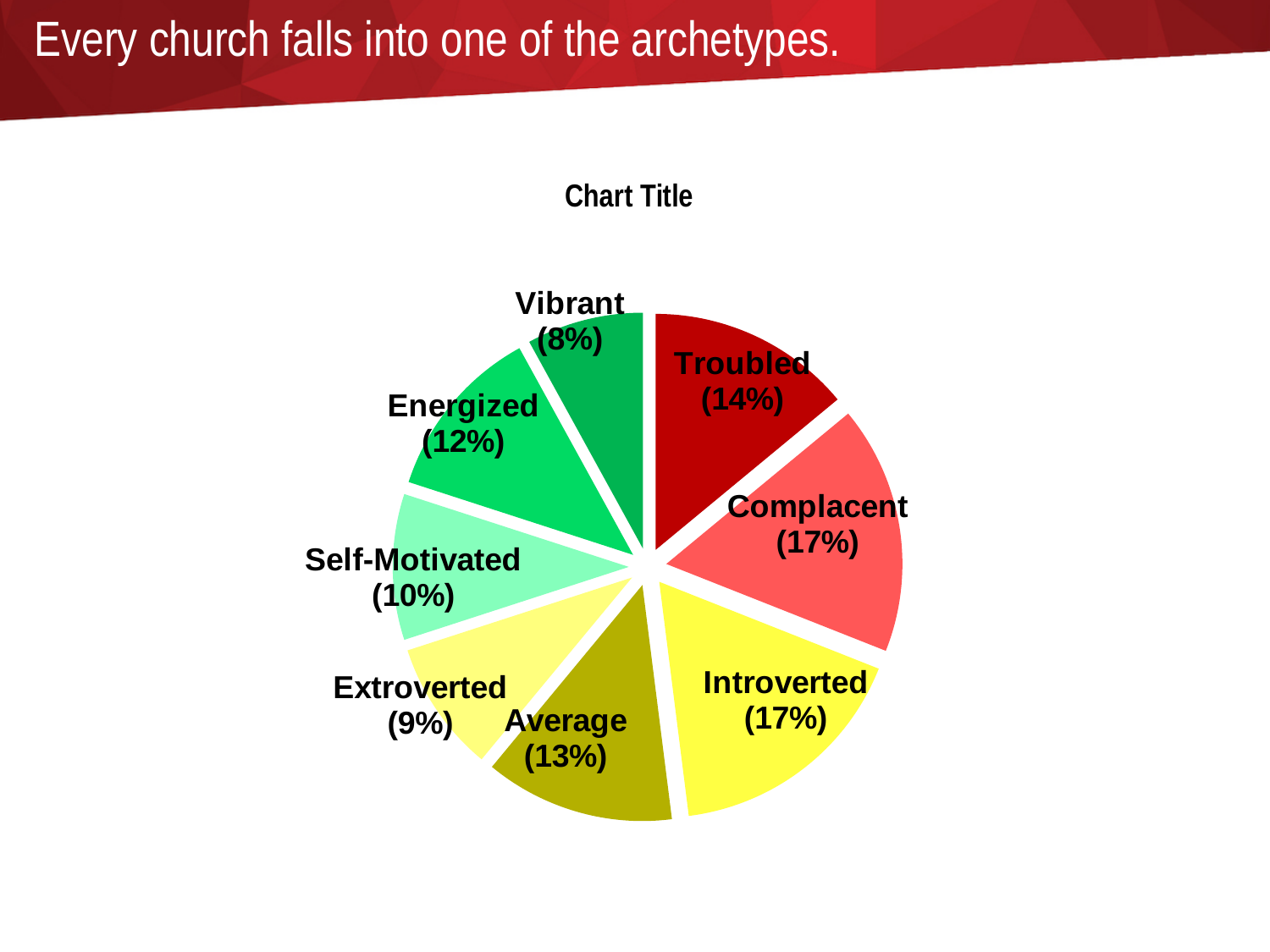
What kind of chart is shown on the slide? pie chart How many slices does the pie chart have? 8 Which archetype has the smallest slice of the pie? Vibrant What is the title printed above the pie chart? Chart Title What is the difference between the Complacent and Troubled percentages? 3% What is the difference between the Average and Vibrant percentages? 5% What colour is the Troubled slice? dark red What percentage of churches are labelled Troubled? 14% What share of the pie does the Average slice represent? 13% Which is larger, the Extroverted slice or the Self-Motivated slice? Self-Motivated What is the value shown for Self-Motivated? 10% What is the value shown for Energized? 12%